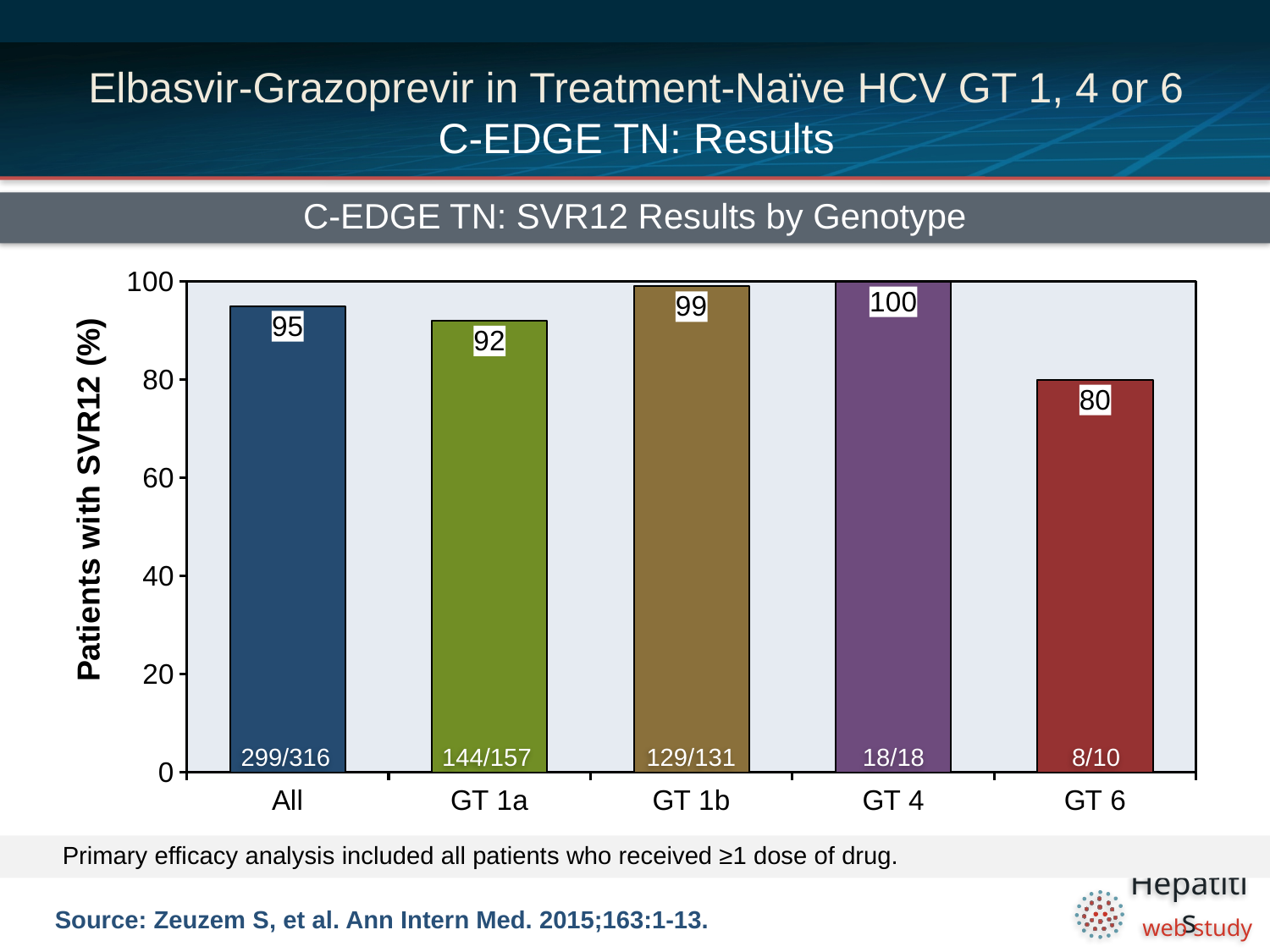
What is the difference in SVR12 rate between GT 4 and GT 6? 20 Which has a higher SVR12 rate, GT 1a or GT 1b? GT 1b What is the SVR12 rate for GT 1a? 92 What fraction of patients is shown inside the GT 1b bar? 129/131 What is the SVR12 rate for GT 6? 80 How many genotype groups are shown on the x axis? 5 What is the difference in SVR12 rate between GT 1b and GT 1a? 7 What kind of chart is shown on the slide? Bar chart What is the title of the chart? C-EDGE TN: SVR12 Results by Genotype What is the SVR12 rate for the All group? 95 Which genotype group has the lowest SVR12 rate? GT 6 Which genotype group has the highest SVR12 rate? GT 4